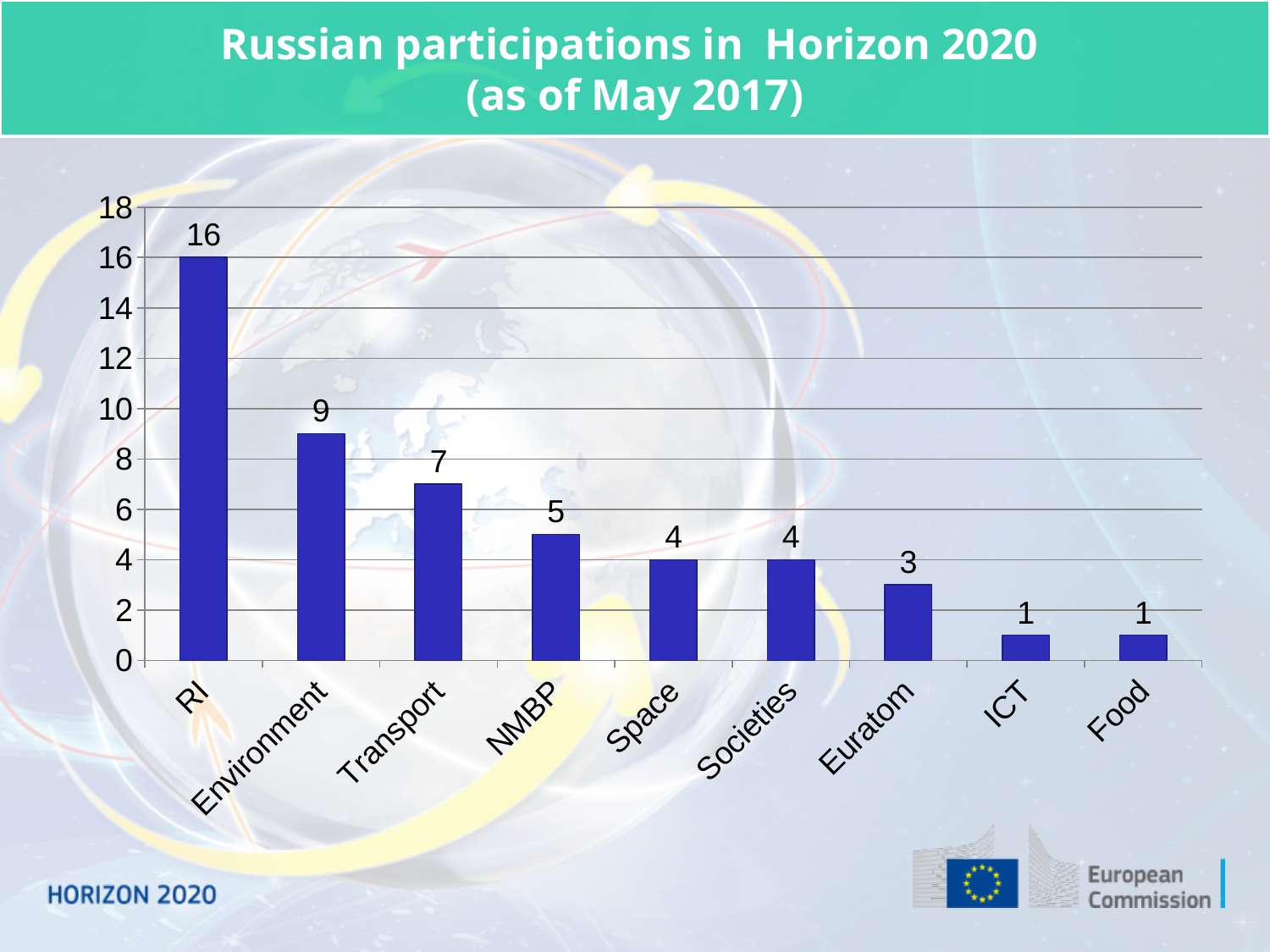
Which category has the highest value? RI What kind of chart is shown on the slide? Bar chart What is the value for RI? 16 Which is larger, the value for Environment or the value for Space? Environment What is the value for Euratom? 3 Is the value for Transport greater or less than 6? greater How many categories are shown on the x axis? 9 What is the difference between the values for NMBP and Euratom? 2 What is the difference between the values for RI and Transport? 9 Do the values rise or fall from left to right along the x axis? Fall What is the title of the slide? Russian participations in Horizon 2020 (as of May 2017) What is the value for Environment? 9